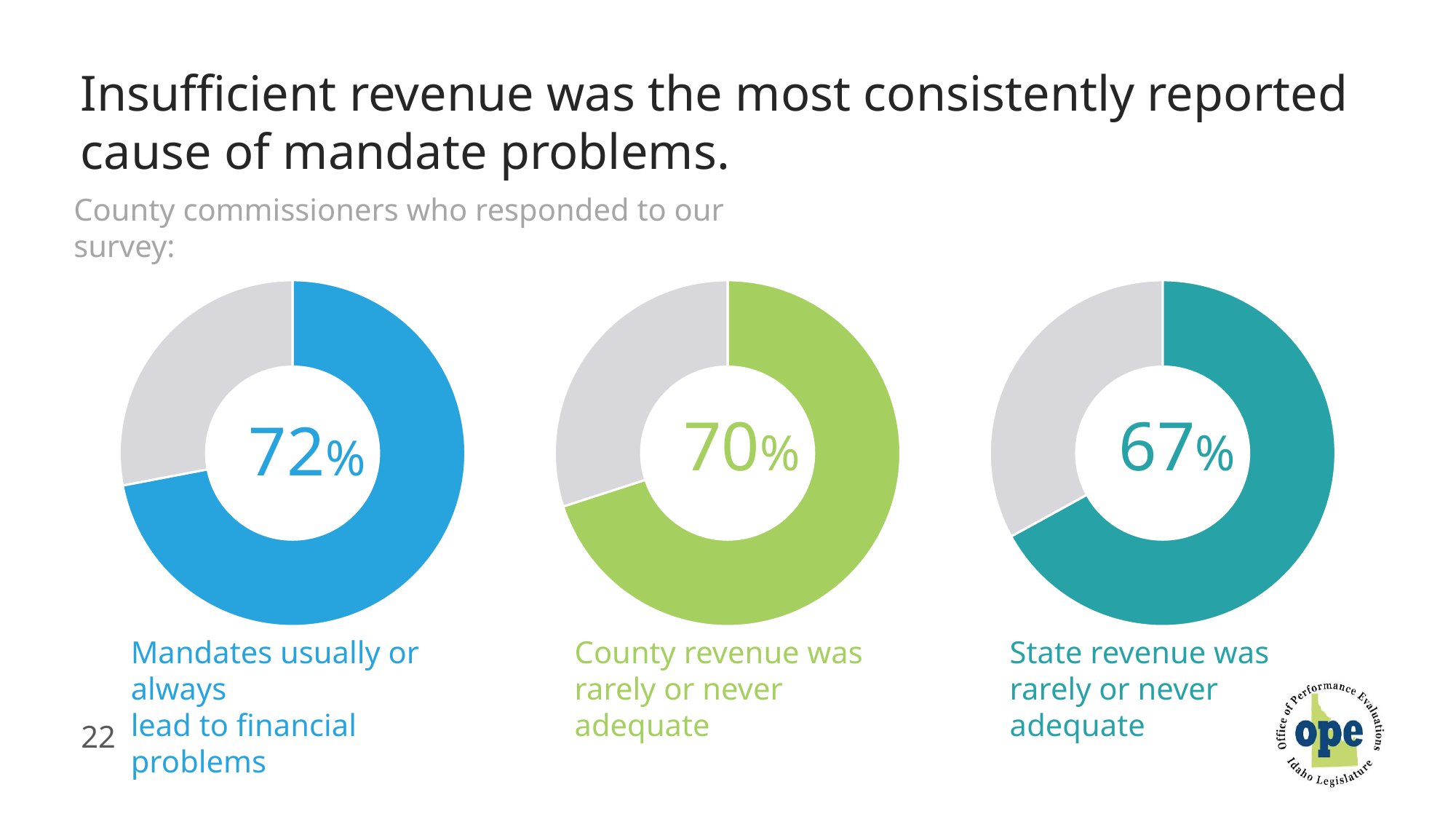
What colour is the filled segment of the middle chart (county revenue rarely or never adequate)? Green What is the difference in percentage points between the left chart (mandates lead to financial problems) and the right chart (state revenue rarely or never adequate)? 5 percentage points How many donut charts are shown on the slide? 3 Which of the three charts shows the lowest percentage? State revenue was rarely or never adequate (67%) What kind of chart is used to display the survey results on this slide? Donut (pie) chart In the right chart, what percentage of county commissioners said state revenue was rarely or never adequate? 67% Which of the three charts shows the highest percentage? Mandates usually or always lead to financial problems (72%) What is the difference in percentage points between the middle chart (county revenue) and the right chart (state revenue)? 3 percentage points In the middle chart, what percentage of county commissioners said county revenue was rarely or never adequate? 70% Which is larger: the percentage for county revenue being rarely or never adequate, or the percentage for state revenue being rarely or never adequate? County revenue (70%) What percentage of county commissioners said mandates usually or always lead to financial problems, according to the left chart? 72% In the left chart, what share of the ring is filled by the coloured (blue) segment? 72%